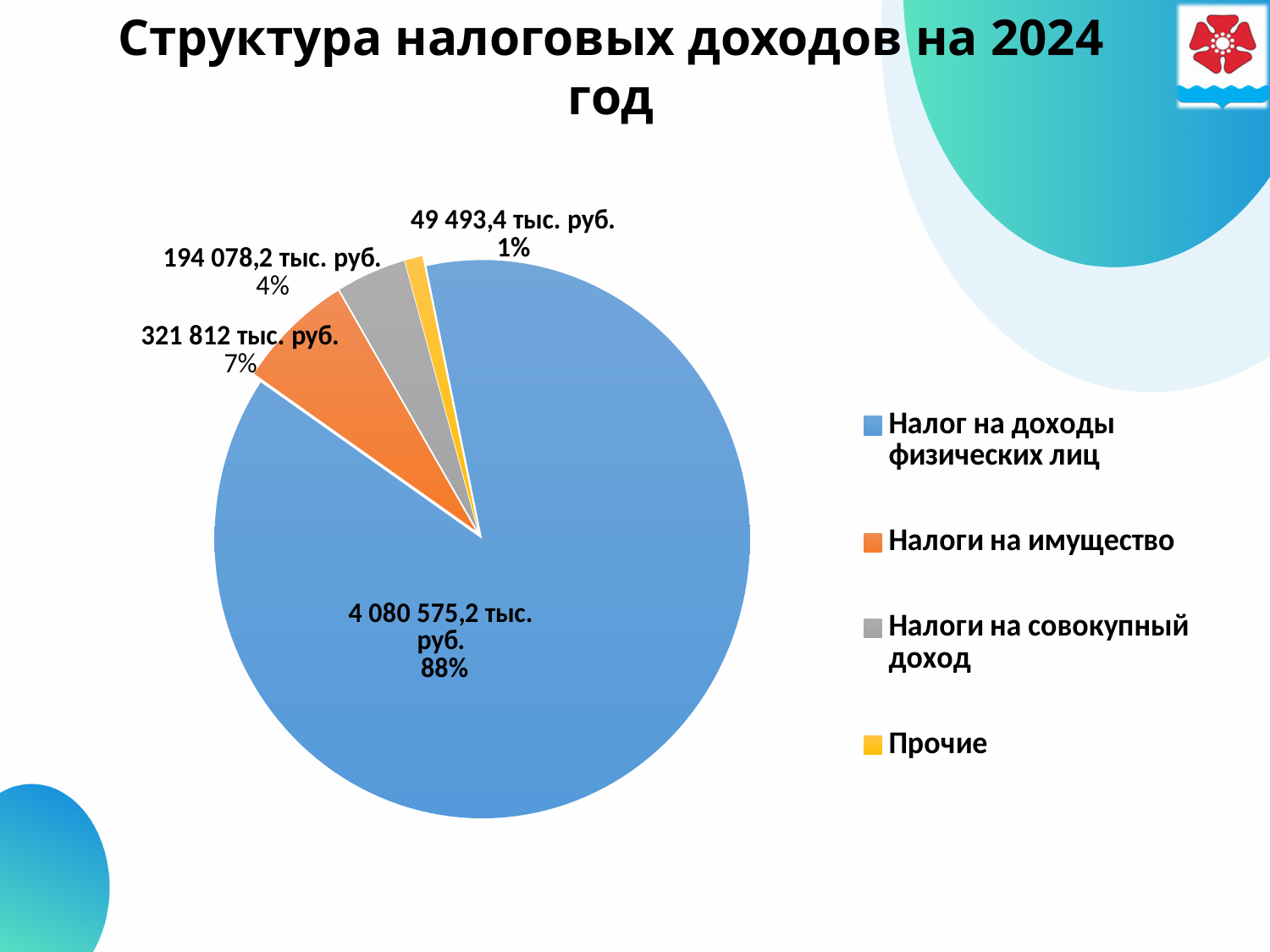
Which is larger, Налоги на имущество or Прочие? Налоги на имущество What share of the pie does Налог на доходы физических лиц represent? 88% What is the value for Налоги на совокупный доход? 194 078,2 тыс. руб. What is the value for Прочие? 49 493,4 тыс. руб. What is the value for Налоги на имущество? 321 812 тыс. руб. How many categories does the legend list? 4 What type of chart is shown on the slide? Pie chart What is the difference between Налоги на имущество and Налоги на совокупный доход? 127 733,8 тыс. руб. Which category has the smallest slice of the pie? Прочие What is the value for Налог на доходы физических лиц? 4 080 575,2 тыс. руб. Which category has the largest slice of the pie? Налог на доходы физических лиц What share of the pie does Налоги на совокупный доход represent? 4%